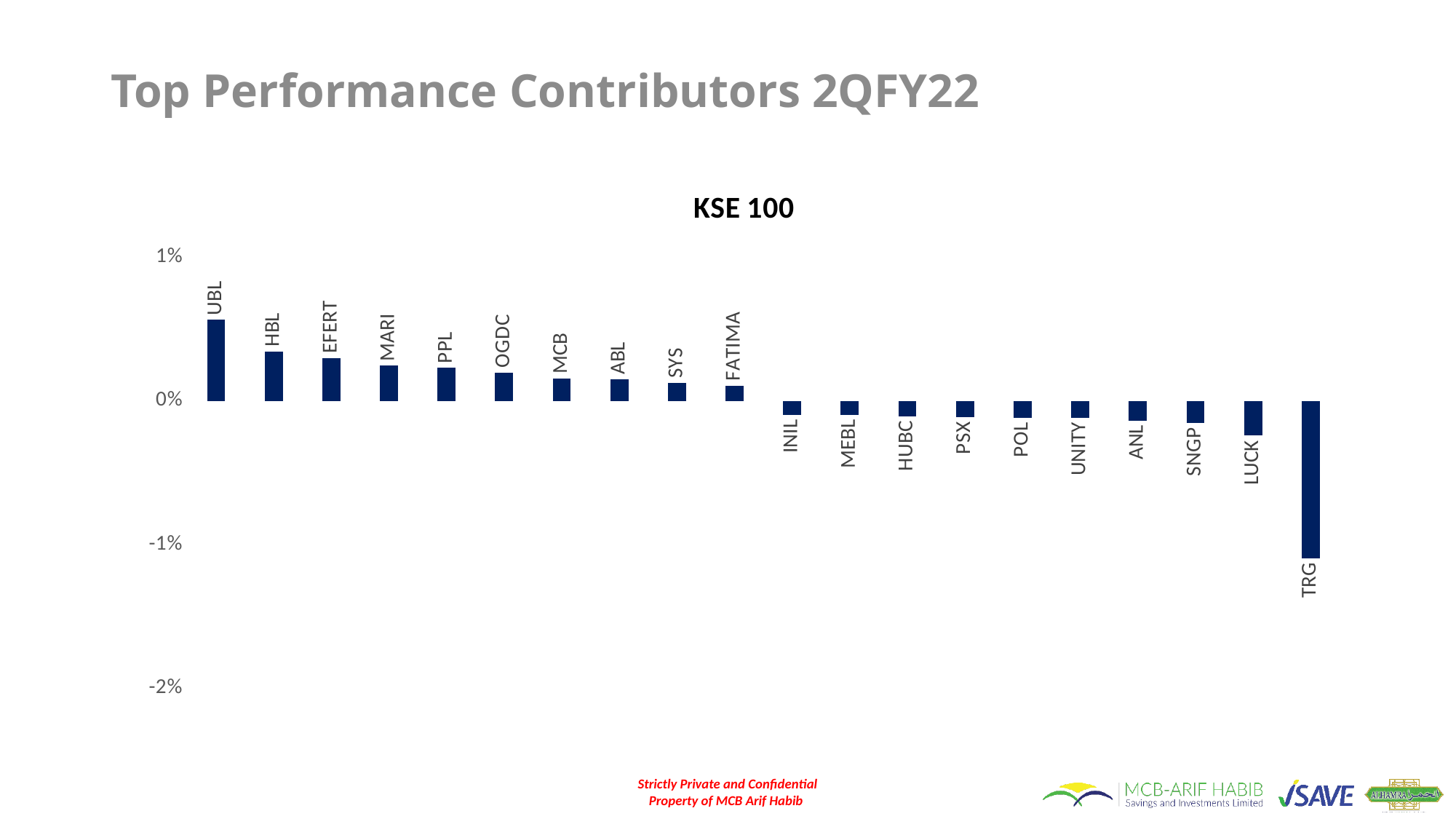
Is the value for TRG greater or less than -2%? greater How many stocks in the chart have a negative value? 10 Do the values rise or fall moving from left to right along the x axis? fall Which stock has the lowest value in the chart? TRG Which stock has the highest value in the chart? UBL How many categories (stocks) are plotted in the chart? 20 Which is larger, the value for LUCK or the value for TRG? LUCK Is the value for INIL greater or less than 0%? less Which is larger, the value for UBL or the value for HBL? UBL What kind of chart is shown on the slide? bar chart Is the value for UBL greater or less than 1%? less What is the title of the chart? KSE 100